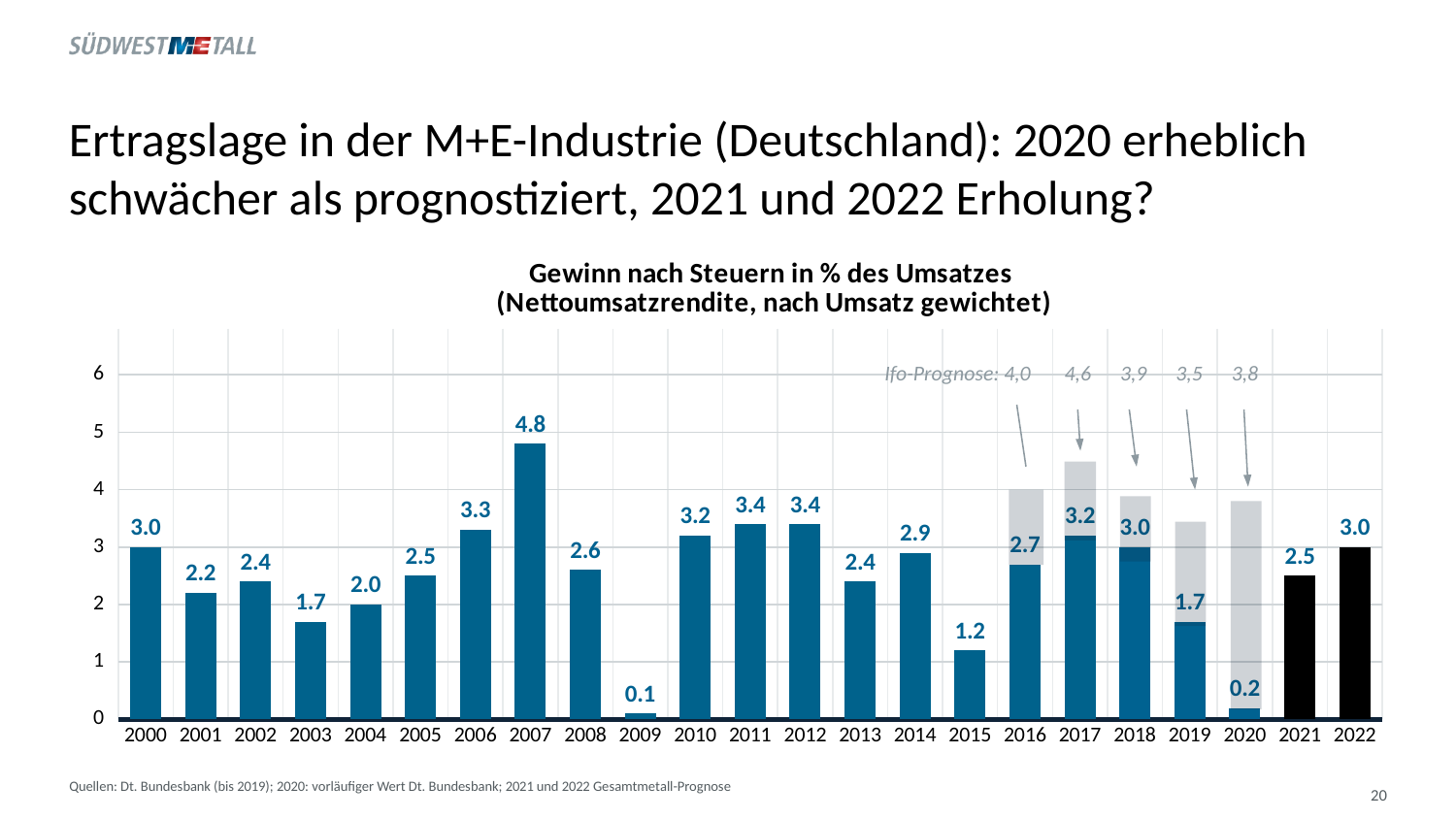
What Ifo-Prognose value is shown for 2017? 4,6 What is the value shown for 2015? 1.2 What is the difference between the values for 2007 and 2008? 2.2 What kind of chart is shown on the slide? Bar chart Which year has the larger value, 2019 or 2021? 2021 Do the values rise or fall from 2017 to 2020? Fall What is the value shown for 2020? 0.2 How many years are shown on the x axis of the chart? 23 What is the value shown for 2007? 4.8 Which year has the lowest value in the chart? 2009 What is the title of the chart? Gewinn nach Steuern in % des Umsatzes (Nettoumsatzrendite, nach Umsatz gewichtet) Which year has the highest value in the chart? 2007